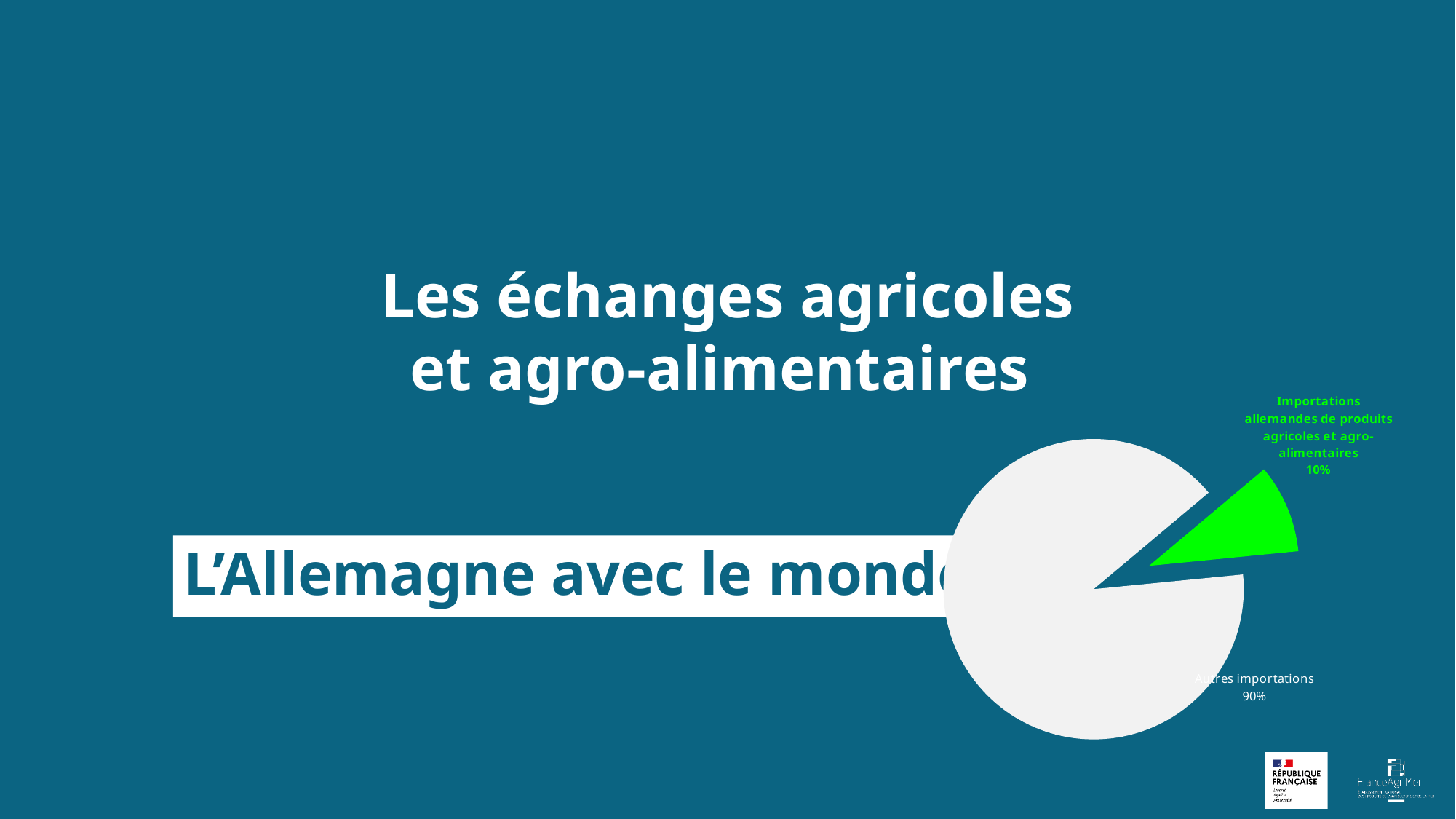
Which slice of the pie chart is the largest? Autres importations How many slices does the pie chart have? 2 What colour is the slice for "Importations allemandes de produits agricoles et agro-alimentaires"? green What is the difference in percentage points between the "Autres importations" slice and the "Importations allemandes de produits agricoles et agro-alimentaires" slice? 80 percentage points What colour is the "Autres importations" slice? white Which slice of the pie chart is the smallest? Importations allemandes de produits agricoles et agro-alimentaires What share of the pie is labelled "Importations allemandes de produits agricoles et agro-alimentaires"? 10% Which is larger: the "Autres importations" slice or the "Importations allemandes de produits agricoles et agro-alimentaires" slice? Autres importations Is the share for "Autres importations" greater or less than 50%? greater What kind of chart is shown on the slide? pie chart What share of the pie is labelled "Autres importations"? 90%